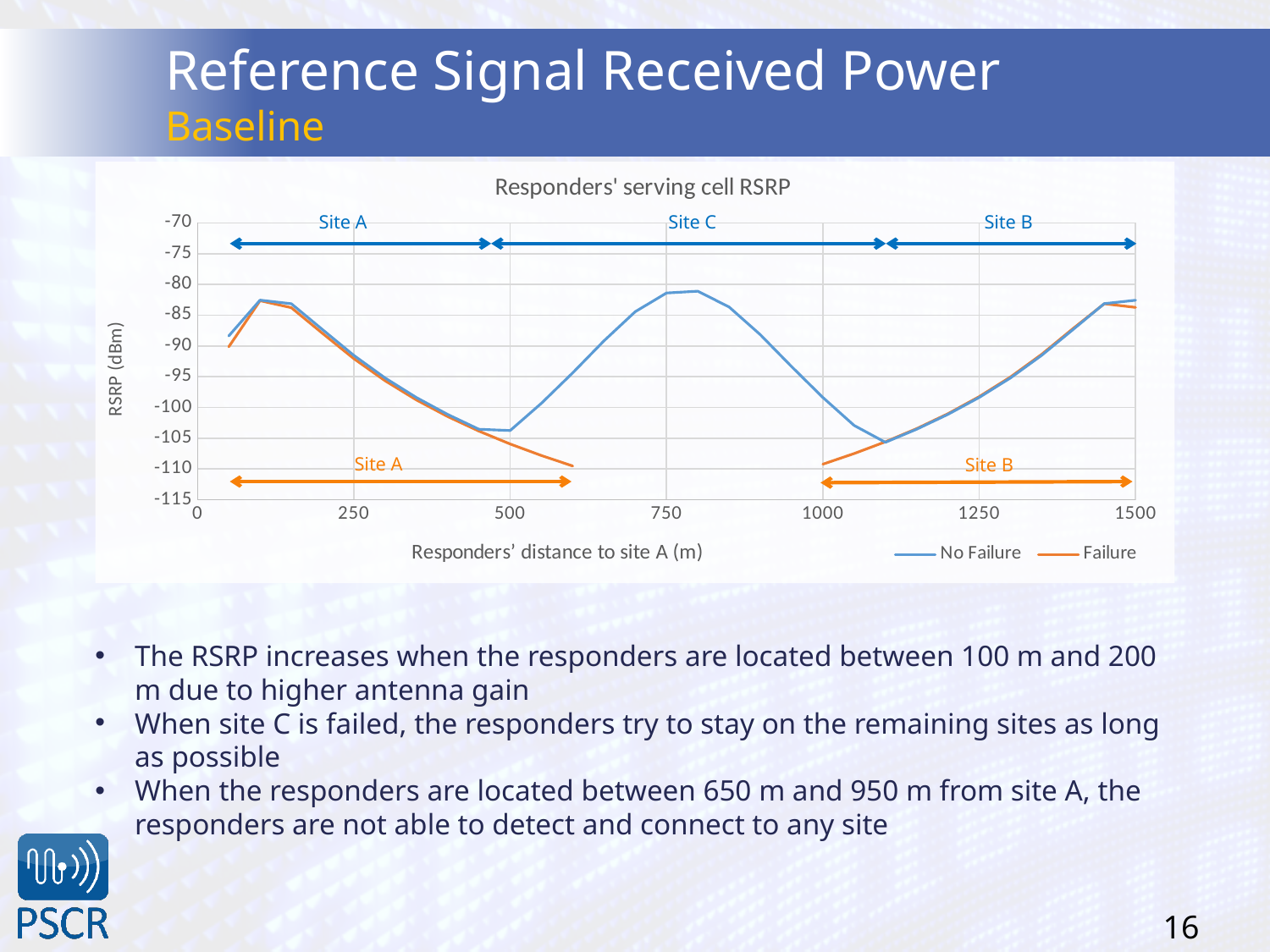
What is the title of the chart? Responders' serving cell RSRP At 600 m, which series has the higher RSRP, No Failure or Failure? No Failure Is the value for No Failure at 500 m greater or less than -100? less Is the value for No Failure at 100 m greater or less than -85? greater Is the value for Failure at 1000 m greater or less than -105? less Does the No Failure series rise or fall between 150 m and 500 m? fall How many series does the chart legend list? 2 Does the No Failure series rise or fall between 500 m and 750 m? rise What kind of chart is shown on the slide? line chart What are the two series named in the chart legend? No Failure and Failure